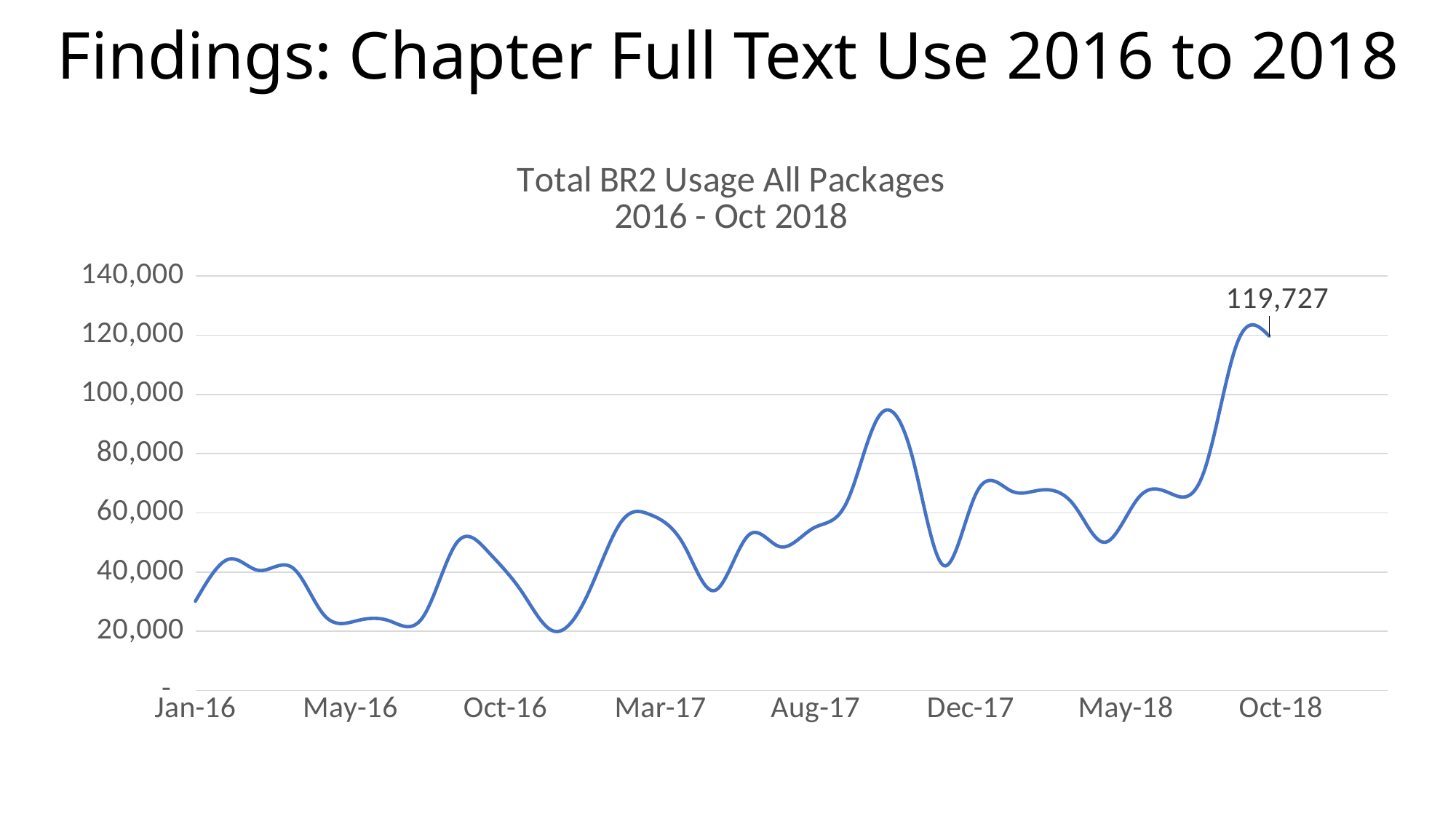
How many month labels are shown on the x axis? 8 Is the value for Dec-17 greater or less than 100,000? less What kind of chart is shown on the slide? line chart Is the value for Mar-17 greater or less than 40,000? greater What is the value labelled at Oct-18? 119,727 Is the value for May-18 greater or less than 100,000? less Overall, does usage rise or fall from Jan-16 to Oct-18? rise What is the title of the chart? Total BR2 Usage All Packages 2016 - Oct 2018 Which month shown on the x axis has the highest usage? Oct-18